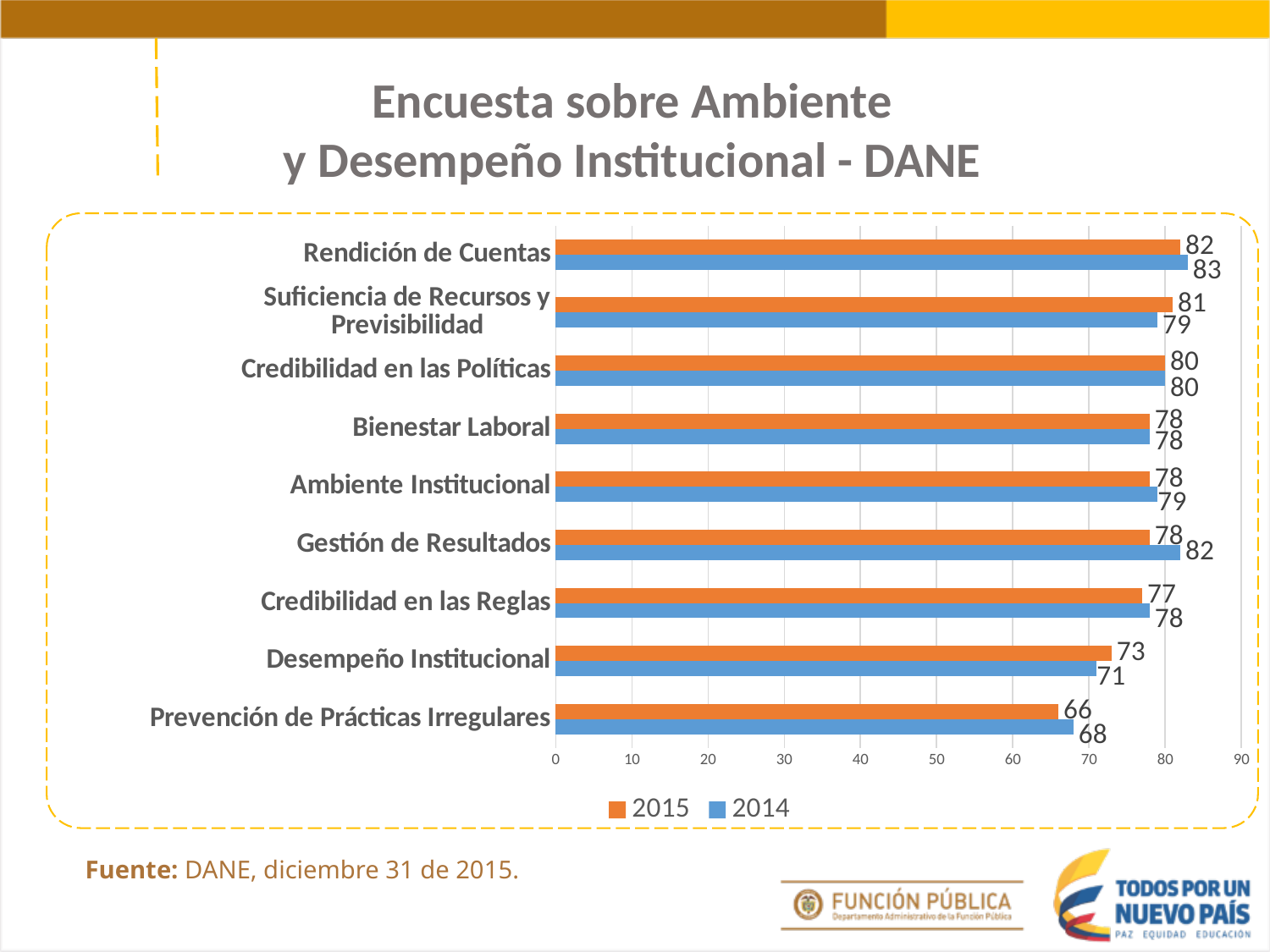
What kind of chart is shown on the slide? Bar chart Which category has the lowest 2015 value? Prevención de Prácticas Irregulares Which colour represents the 2015 series in the legend? Orange For Suficiencia de Recursos y Previsibilidad, which year has the larger value, 2015 or 2014? 2015 How many series does the legend list? 2 What is the 2014 value for Desempeño Institucional? 71 Which category has the highest 2014 value? Rendición de Cuentas What is the 2015 value for Prevención de Prácticas Irregulares? 66 What is the difference between the 2014 and 2015 values for Gestión de Resultados? 4 How many categories are shown on the chart? 9 What is the 2015 value for Rendición de Cuentas? 82 What is the 2014 value for Credibilidad en las Reglas? 78